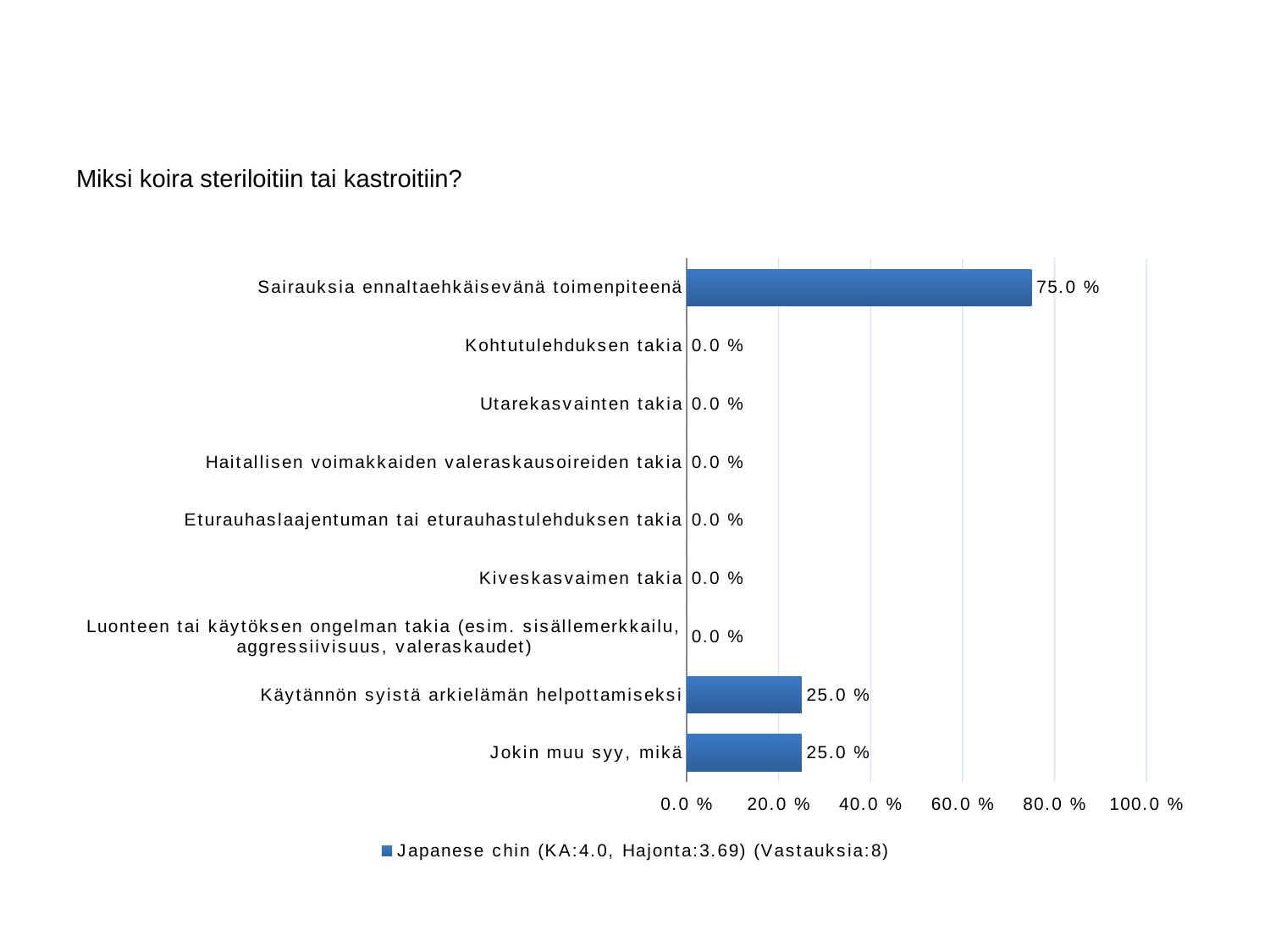
How many categories are shown on the chart? 9 What is the value for "Jokin muu syy, mikä"? 25.0 % What is the value for "Sairauksia ennaltaehkäisevänä toimenpiteenä"? 75.0 % What is the value for "Kohtutulehduksen takia"? 0.0 % What is the title of the chart? Miksi koira steriloitiin tai kastroitiin? Which is larger: the value for "Sairauksia ennaltaehkäisevänä toimenpiteenä" or the value for "Käytännön syistä arkielämän helpottamiseksi"? Sairauksia ennaltaehkäisevänä toimenpiteenä What is the difference between the values for "Sairauksia ennaltaehkäisevänä toimenpiteenä" and "Jokin muu syy, mikä"? 50.0 % How many series does the legend list? 1 What kind of chart is shown on the slide? bar chart What is the value for "Käytännön syistä arkielämän helpottamiseksi"? 25.0 % Which category has the highest value? Sairauksia ennaltaehkäisevänä toimenpiteenä Is the value for "Sairauksia ennaltaehkäisevänä toimenpiteenä" greater or less than 60.0 %? greater